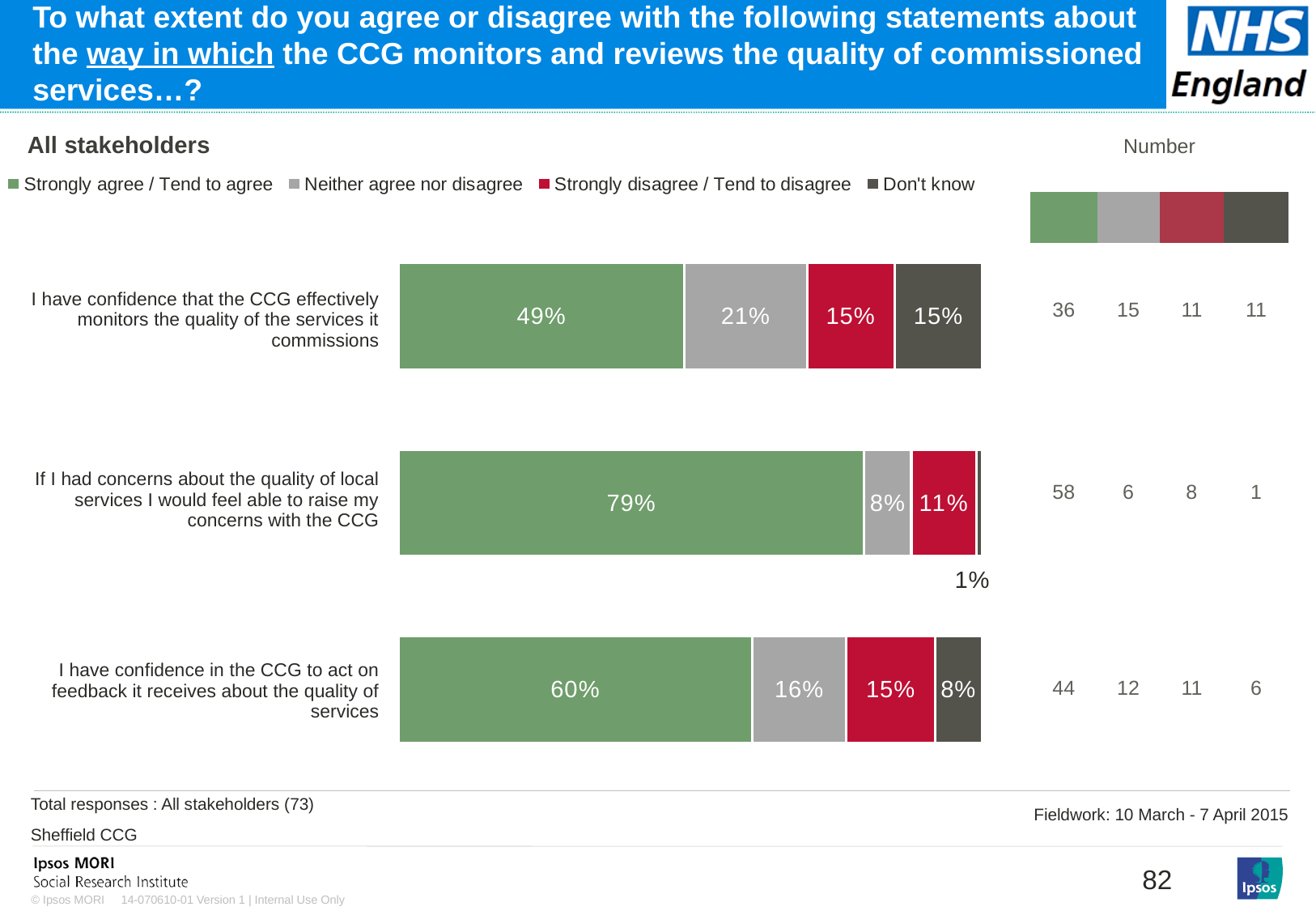
How many response categories does the legend list? 4 What percentage of stakeholders neither agree nor disagree that they have confidence that the CCG effectively monitors the quality of the services it commissions? 21% What percentage of stakeholders strongly agree or tend to agree that they have confidence that the CCG effectively monitors the quality of the services it commissions? 49% What percentage of stakeholders answered 'Don't know' for the statement 'I have confidence in the CCG to act on feedback it receives about the quality of services'? 8% What type of chart is used on this slide? Stacked bar chart According to the 'Number' column, how many stakeholders strongly agree or tend to agree that they have confidence in the CCG to act on feedback it receives about the quality of services? 44 What percentage of stakeholders strongly agree or tend to agree that if they had concerns about the quality of local services they would feel able to raise them with the CCG? 79% What is the difference in percentage points between the agree share for 'If I had concerns about the quality of local services I would feel able to raise my concerns with the CCG' and the agree share for 'I have confidence in the CCG to act on feedback it receives about the quality of services'? 19 percentage points Which statement has the lowest 'Don't know' percentage? If I had concerns about the quality of local services I would feel able to raise my concerns with the CCG Is the 'Neither agree nor disagree' share larger for 'I have confidence that the CCG effectively monitors the quality of the services it commissions' or for 'I have confidence in the CCG to act on feedback it receives about the quality of services'? I have confidence that the CCG effectively monitors the quality of the services it commissions Which statement has the highest percentage of stakeholders who strongly agree or tend to agree? If I had concerns about the quality of local services I would feel able to raise my concerns with the CCG How many statements are shown in the chart? 3